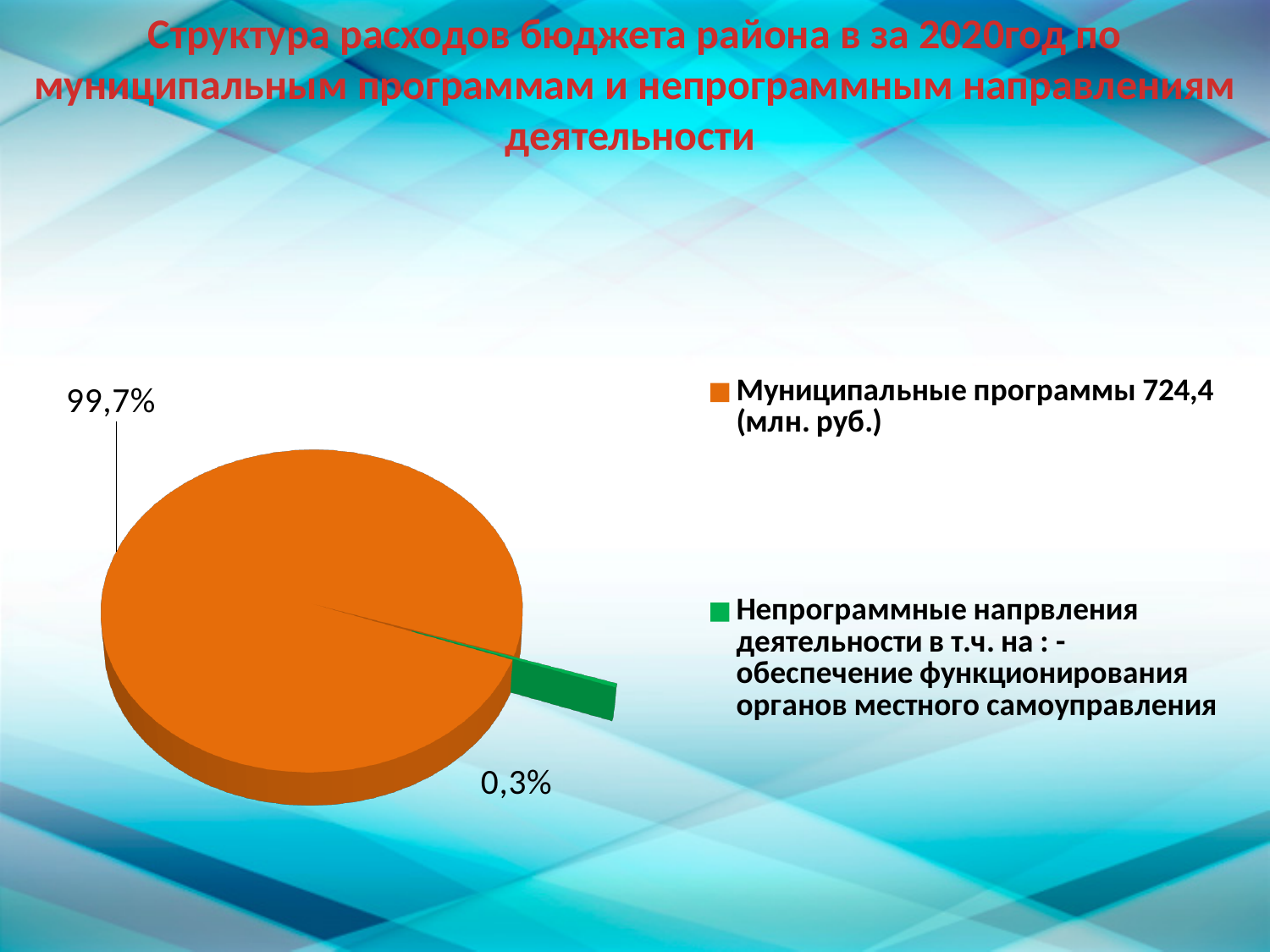
What kind of chart is shown on the slide? Pie chart What amount in million rubles is given in the legend for Муниципальные программы? 724,4 What share of the pie is labelled for Муниципальные программы? 99,7% What is the difference in percentage points between the Муниципальные программы slice and the Непрограммные напрвления деятельности slice? 99,4 Which slice is larger: Муниципальные программы or Непрограммные напрвления деятельности? Муниципальные программы What colour is the slice for Муниципальные программы? Orange Which category has the smallest slice of the pie? Непрограммные напрвления деятельности What share of the pie is labelled for Непрограммные напрвления деятельности? 0,3% Is the share for Муниципальные программы greater or less than 50%? greater How many slices does the pie chart have? 2 How many entries does the legend list? 2 Which category has the largest slice of the pie? Муниципальные программы